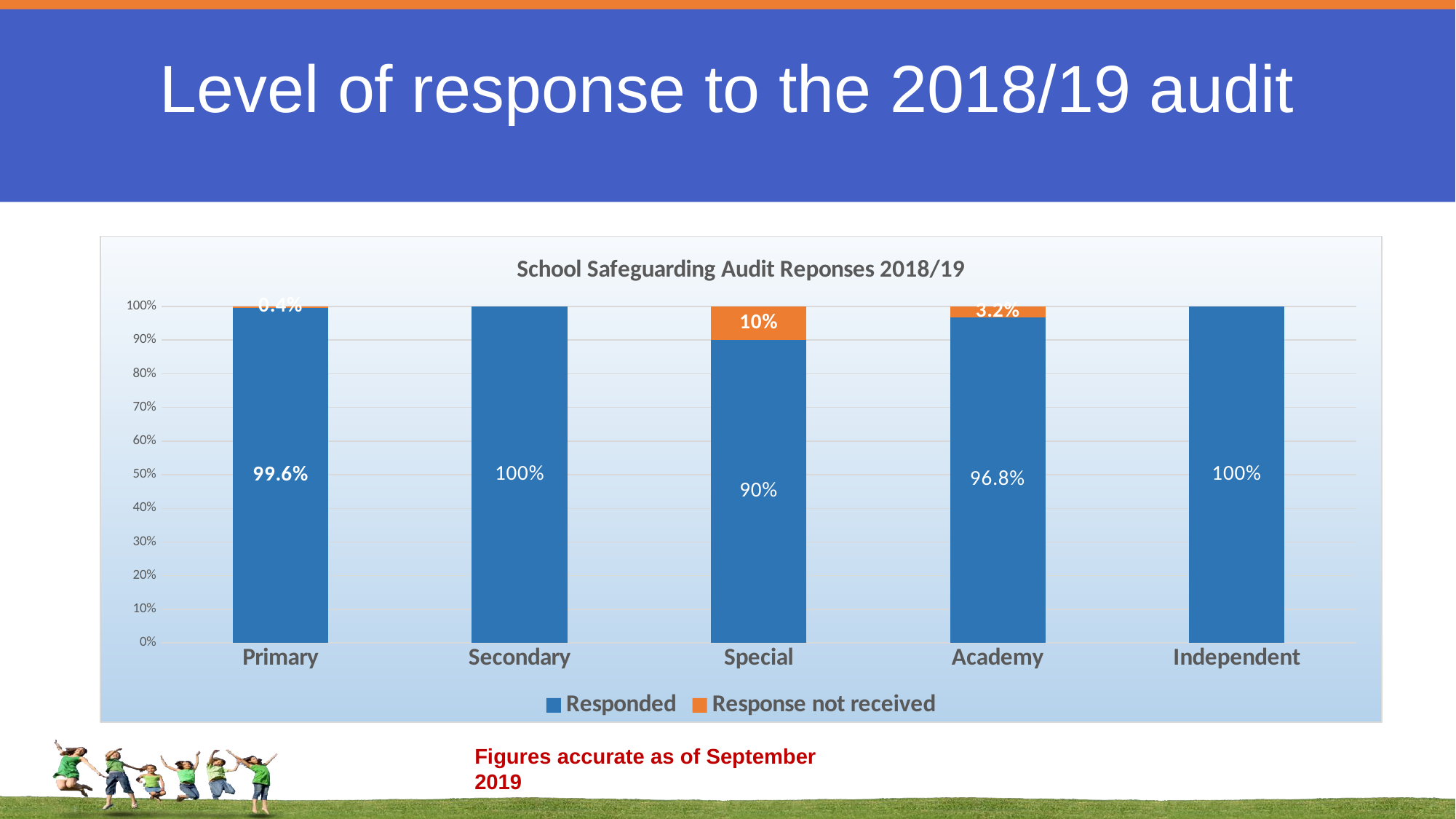
Which category has the highest Response not received value? Special What is the Responded value for Primary? 99.6% What kind of chart is shown? Stacked bar chart How many series does the legend list? 2 How many categories are shown on the x axis? 5 What is the Response not received value for Special? 10% What is the Responded value for Special? 90% What is the Response not received value for Academy? 3.2% What is the difference between the Responded values for Primary and Academy? 2.8% Which has a larger Responded value, Academy or Special? Academy What is the title of the chart? School Safeguarding Audit Reponses 2018/19 Which category has the lowest Responded value? Special